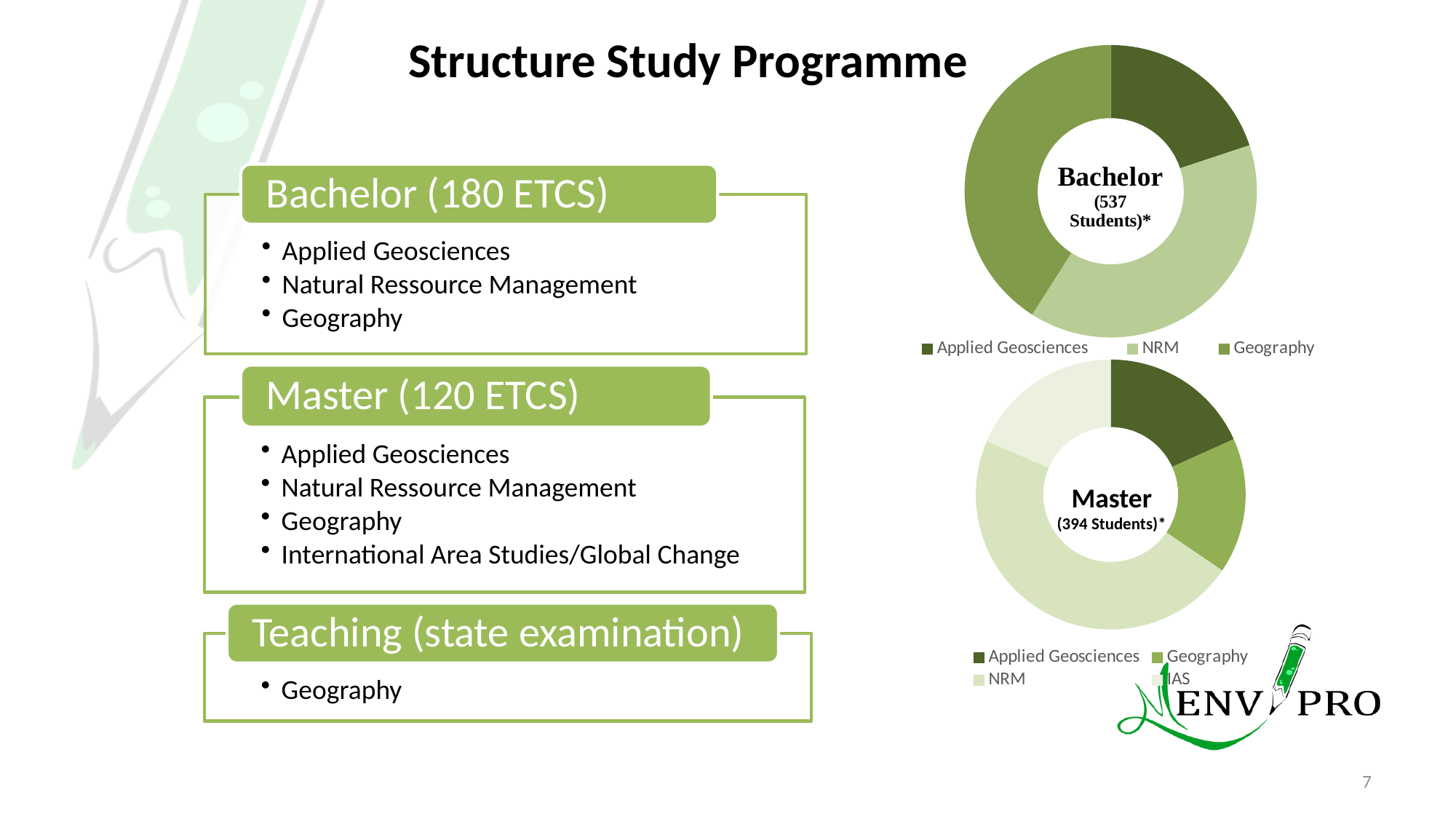
What kind of chart is the Master chart on the right of the slide? Doughnut chart In the Bachelor chart, how many students are stated in the centre of the chart? 537 Students How many categories does the legend of the Bachelor chart list? 3 What kind of chart is the Bachelor chart on the right of the slide? Doughnut chart How many more students does the Bachelor chart report than the Master chart? 143 In the Bachelor chart, which category has the smallest slice? Applied Geosciences In the Master chart, how many students are stated in the centre of the chart? 394 Students In the Master chart, which category has the largest slice? NRM In the Master chart, which slice is larger, NRM or Geography? NRM Which category appears in the legend of the Master chart but not in the legend of the Bachelor chart? IAS How many categories does the legend of the Master chart list? 4 In the Bachelor chart, which slice is larger, NRM or Applied Geosciences? NRM